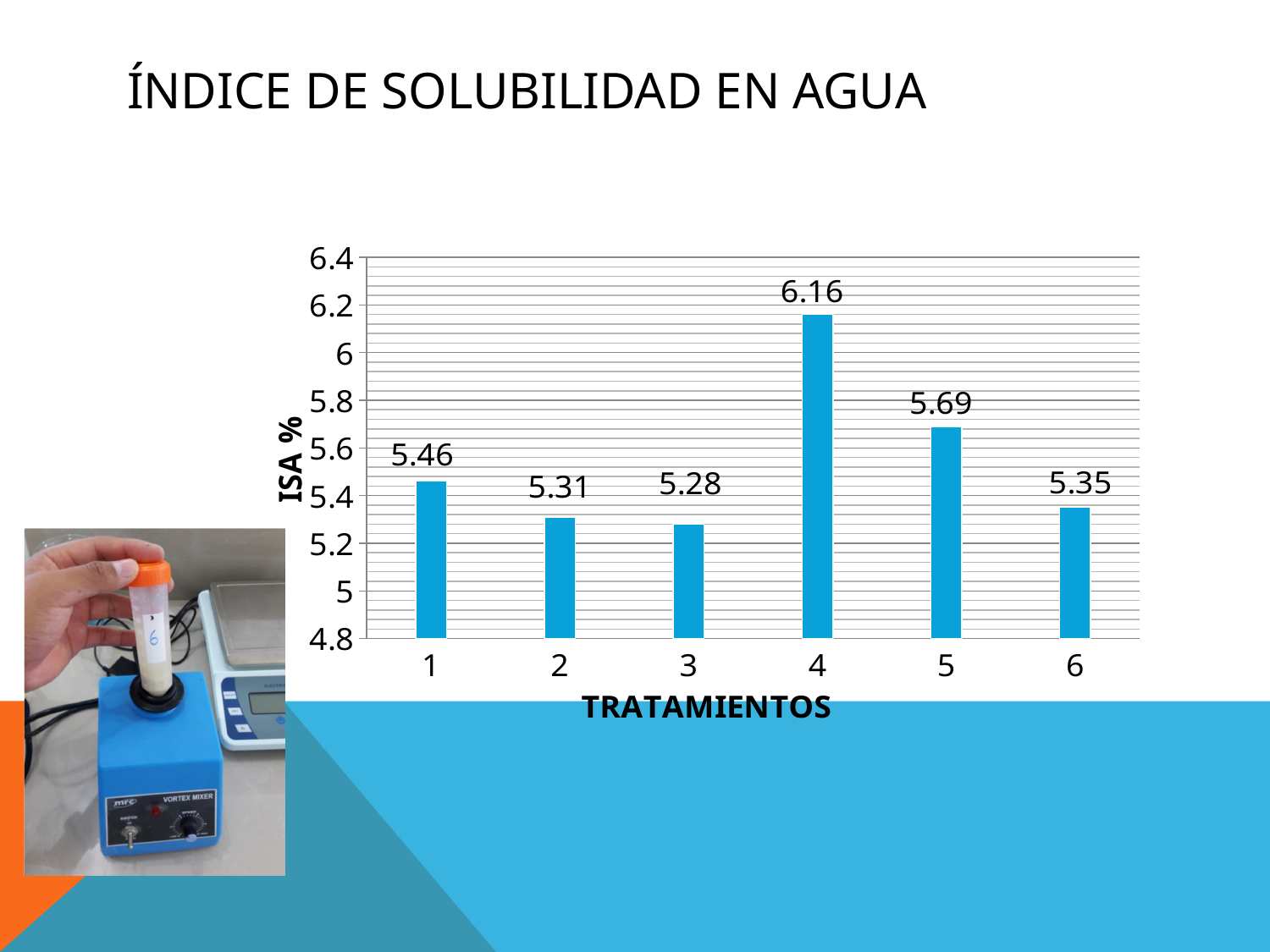
What is the difference in ISA % between tratamiento 1 and tratamiento 3? 0.18 How many tratamientos are shown on the x axis of the chart? 6 Is the ISA % value for tratamiento 4 greater or less than 6? greater What is the difference in ISA % between tratamiento 4 and tratamiento 5? 0.47 Which has a higher ISA %, tratamiento 2 or tratamiento 5? Tratamiento 5 What is the ISA % value for tratamiento 1? 5.46 Which tratamiento has the lowest ISA %? 3 Which tratamiento has the highest ISA %? 4 What is the ISA % value for tratamiento 4? 6.16 What is the ISA % value for tratamiento 6? 5.35 What is the label of the y axis of the chart? ISA % What type of chart is shown on the slide? Bar chart